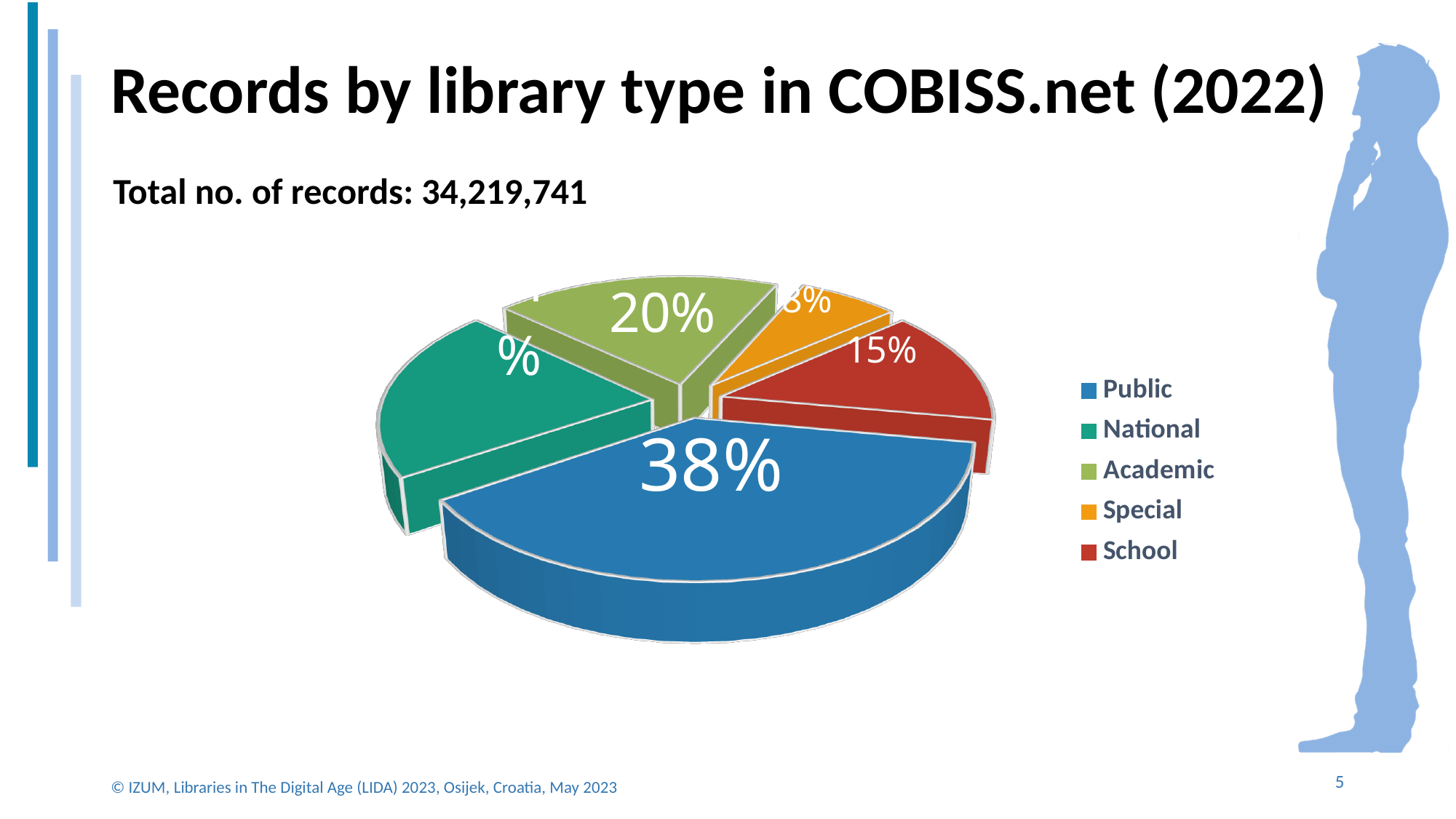
What is the title of the chart slide? Records by library type in COBISS.net (2022) How many percentage points larger is the Public share than the Academic share? 18 percentage points How many percentage points larger is the Academic share than the School share? 5 percentage points What share of records do School libraries account for? 15% Which has a larger share of records, Academic or School libraries? Academic What share of records do Academic libraries account for? 20% What share of records do Public libraries account for? 38% Which has a larger share of records, Public or Academic libraries? Public What kind of chart is shown on the slide? pie chart How many library types does the legend list? 5 Which library type has the largest share of records? Public Which library type has the smallest share of records? Special